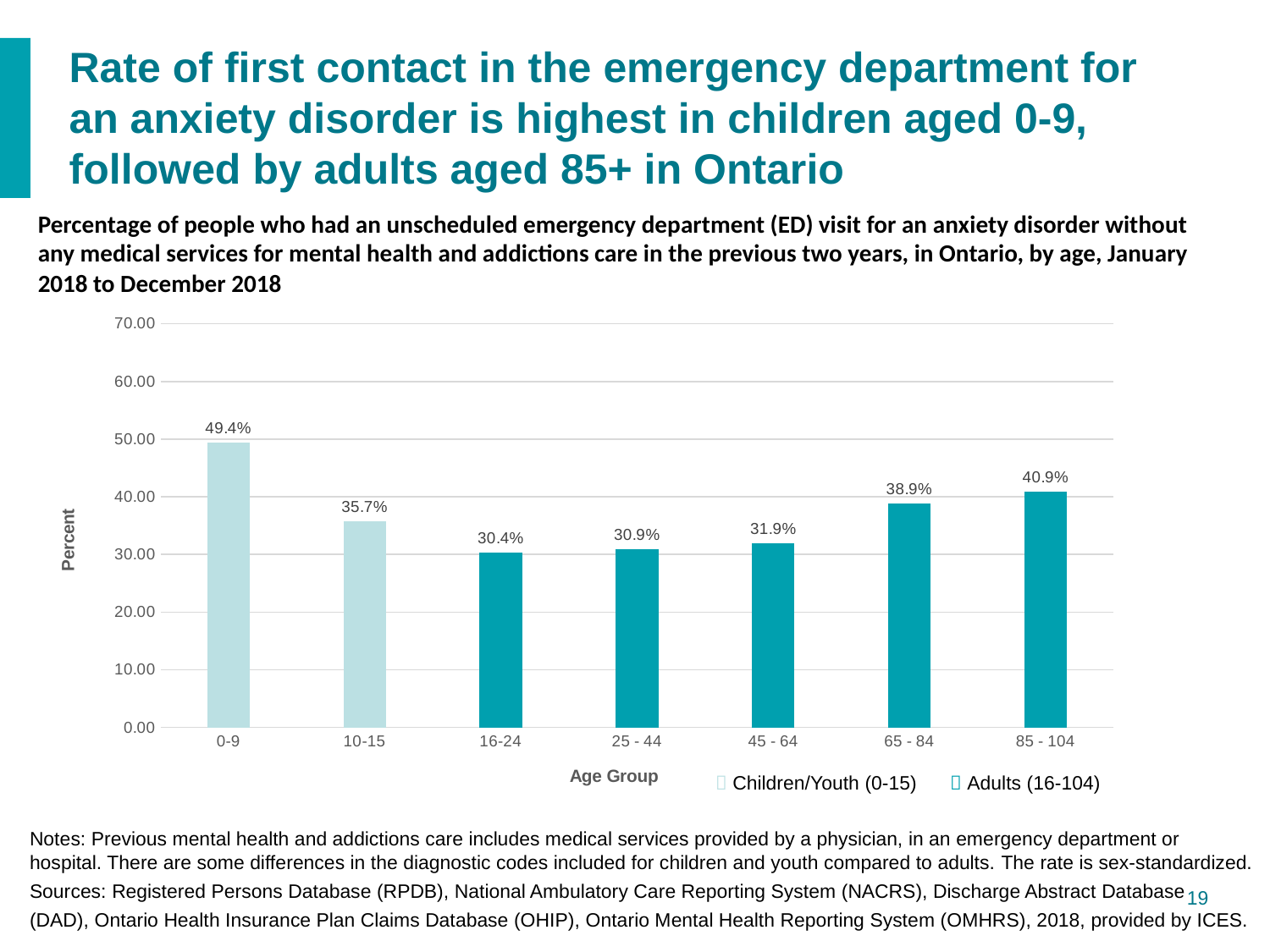
How many age groups are shown on the x axis? 7 What is the difference between the values for the 0-9 and 85 - 104 age groups? 8.5% Which is larger, the value for 10-15 or the value for 45 - 64? 10-15 What is the value for the 65 - 84 age group? 38.9% What is the value for the 0-9 age group? 49.4% What kind of chart is shown on the slide? bar chart Is the value for the 85 - 104 age group greater or less than 40.00? greater How many series does the legend list? 2 Which age group has the lowest value? 16-24 Which age group has the highest value? 0-9 What is the value for the 25 - 44 age group? 30.9% What is the label of the y axis? Percent